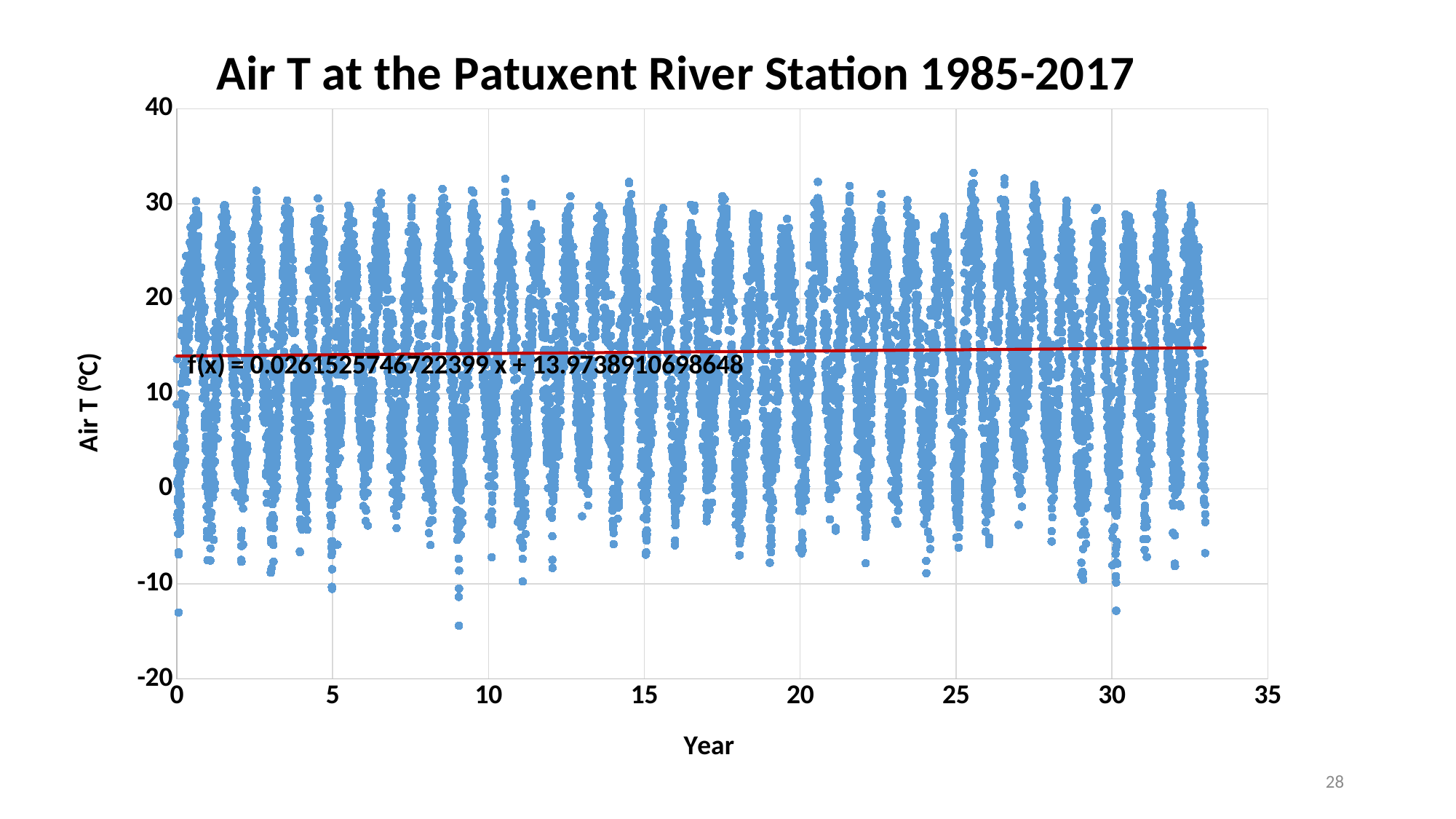
Is the lowest plotted air temperature greater or less than -10? less Is the highest plotted air temperature greater or less than 30? greater What is the highest value shown on the x axis? 35 What is the slope of the fitted trend line f(x) shown on the chart? 0.0261525746722399 Is the value of the red trend line at year 30 greater or less than 20? less What kind of chart is shown on the slide? scatter chart What is the highest value shown on the y axis? 40 Does the red trend line rise or fall as the year increases? rise What is the label of the y axis? Air T (°C) What is the intercept of the fitted trend line f(x) shown on the chart? 13.97389106986648 What is the title of the chart? Air T at the Patuxent River Station 1985-2017